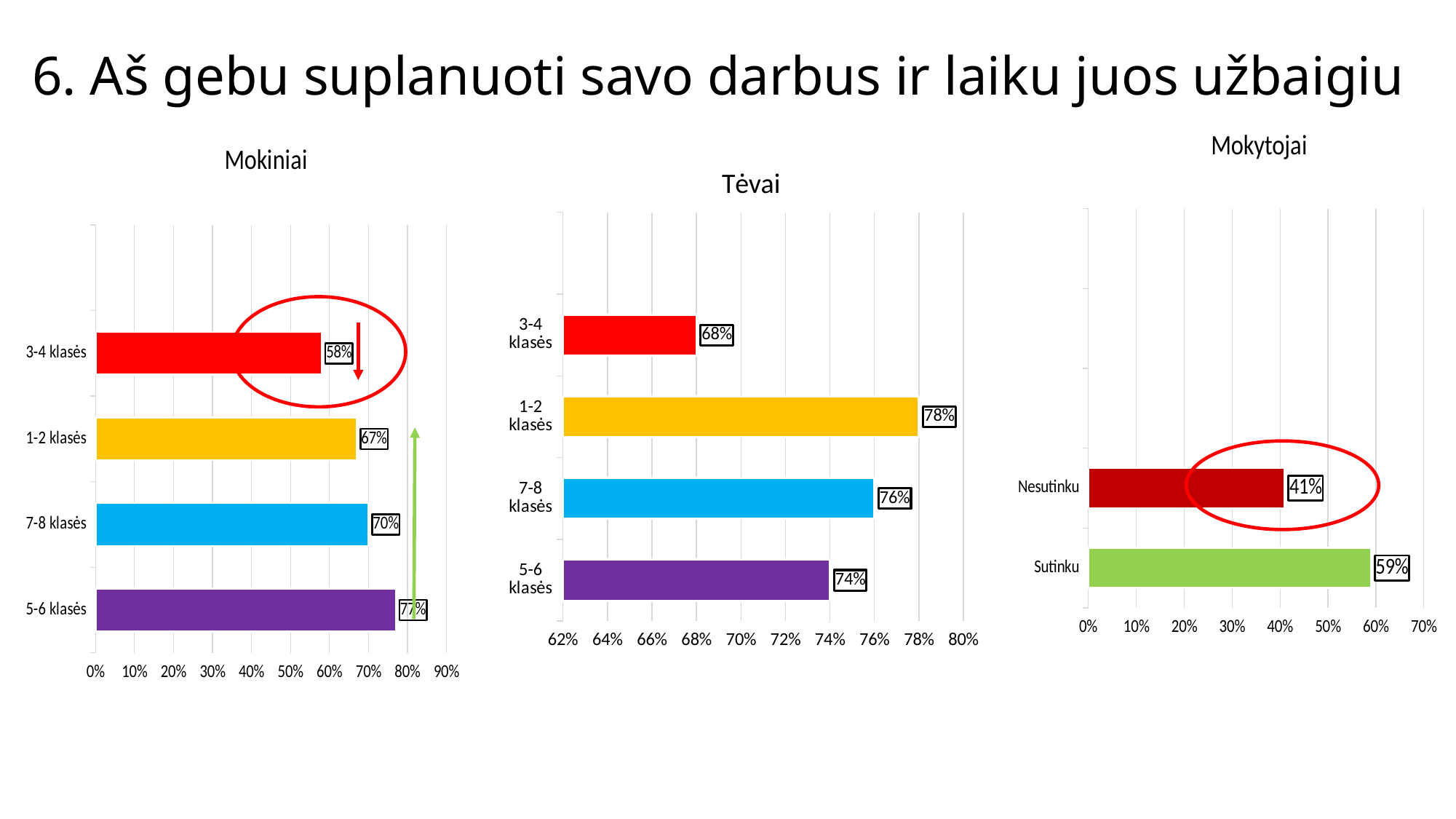
In the Mokiniai chart, what is the value for 3-4 klasės? 58% What kind of chart is the Mokytojai chart? bar chart In the Mokytojai chart, what is the difference between Sutinku and Nesutinku? 18% In the Tėvai chart, which is larger, 7-8 klasės or 5-6 klasės? 7-8 klasės In the Mokiniai chart, what is the difference between 5-6 klasės and 3-4 klasės? 19% In the Mokiniai chart, how many categories are shown? 4 In the Mokytojai chart, what colour is the Nesutinku bar? dark red In the Tėvai chart, which category has the lowest value? 3-4 klasės In the Mokytojai chart, what is the value for Sutinku? 59% In the Tėvai chart, what is the value for 1-2 klasės? 78% In the Tėvai chart, what is the difference between 1-2 klasės and 3-4 klasės? 10% In the Mokiniai chart, which category has the highest value? 5-6 klasės